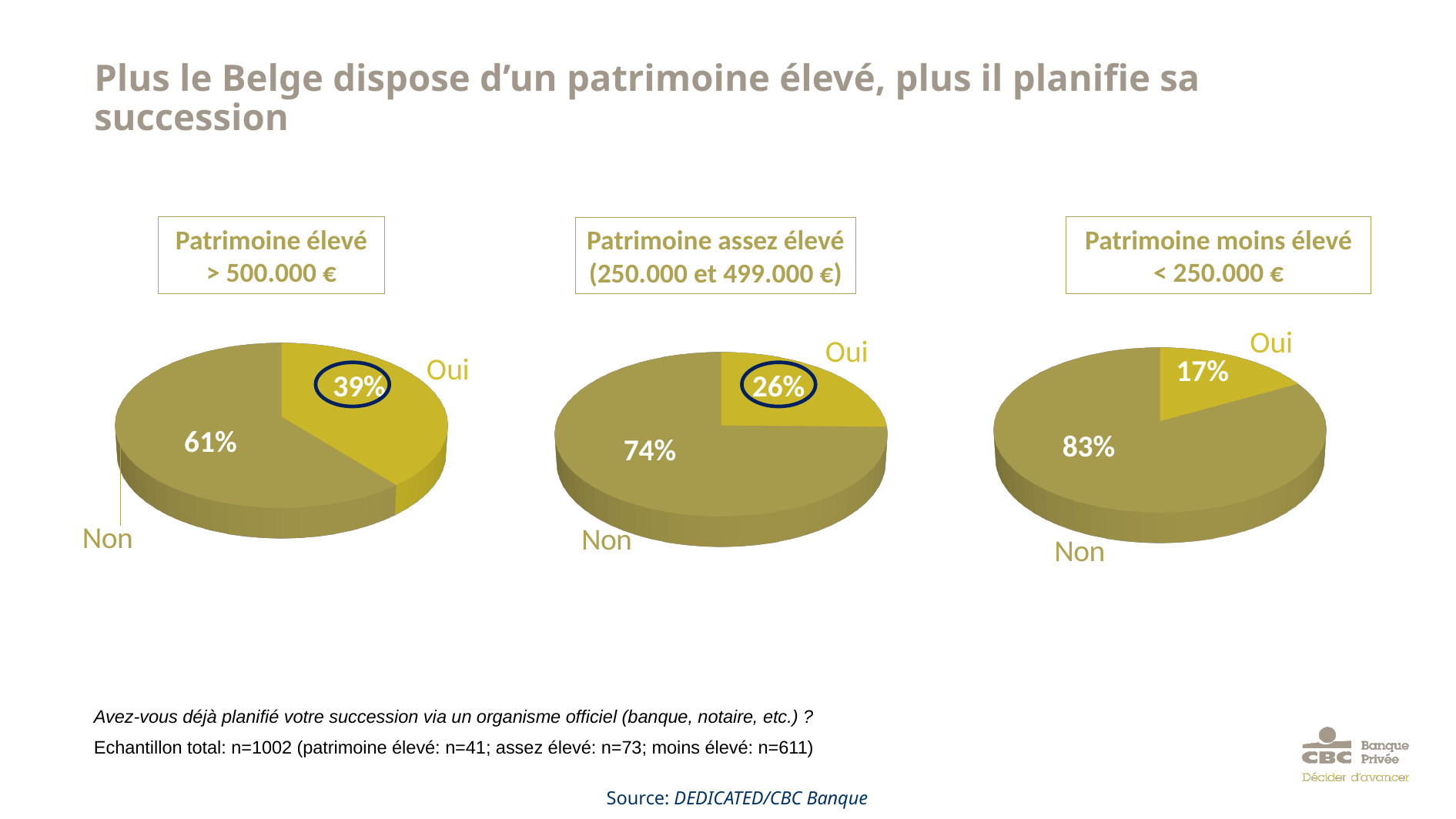
In the 'Patrimoine élevé > 500.000 €' pie chart, which slice is the smallest? Oui In the 'Patrimoine moins élevé < 250.000 €' pie chart, which slice is the largest? Non In the 'Patrimoine assez élevé (250.000 et 499.000 €)' pie chart, what is the value for Oui? 26% In the 'Patrimoine assez élevé (250.000 et 499.000 €)' pie chart, what is the difference between Non and Oui? 48% In the 'Patrimoine moins élevé < 250.000 €' pie chart, what is the value for Oui? 17% How many slices does the 'Patrimoine élevé > 500.000 €' pie chart have? 2 In the 'Patrimoine moins élevé < 250.000 €' pie chart, what is the value for Non? 83% Which is larger: the Oui share in the 'Patrimoine élevé > 500.000 €' chart or the Oui share in the 'Patrimoine moins élevé < 250.000 €' chart? Patrimoine élevé > 500.000 € What kind of chart is used on this slide? Pie chart In the 'Patrimoine assez élevé (250.000 et 499.000 €)' pie chart, what is the value for Non? 74% In the 'Patrimoine élevé > 500.000 €' pie chart, what is the value for Non? 61% In the 'Patrimoine élevé > 500.000 €' pie chart, what is the value for Oui? 39%